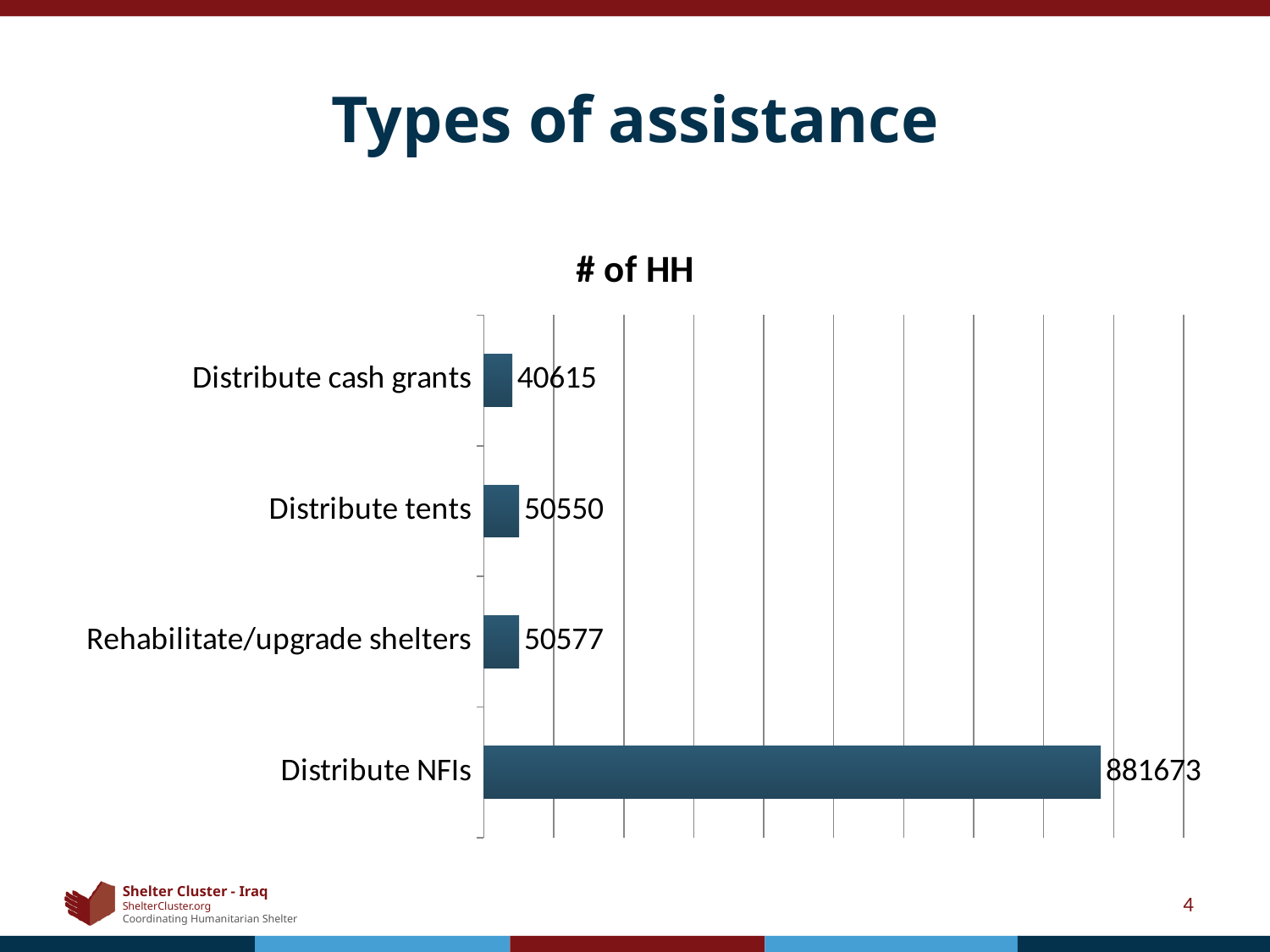
What is the difference between Distribute NFIs and Distribute cash grants? 841058 What kind of chart is shown on the slide? Bar chart Which is larger, the value for Distribute tents or the value for Distribute cash grants? Distribute tents Which type of assistance has the lowest number of households? Distribute cash grants How many households received assistance under Distribute cash grants? 40615 What is the value for Distribute NFIs? 881673 Which type of assistance has the highest number of households? Distribute NFIs What is the difference between Rehabilitate/upgrade shelters and Distribute tents? 27 How many types of assistance are shown in the chart? 4 What is the value shown for Distribute tents? 50550 What is the value shown for Rehabilitate/upgrade shelters? 50577 What is the title of the chart? # of HH